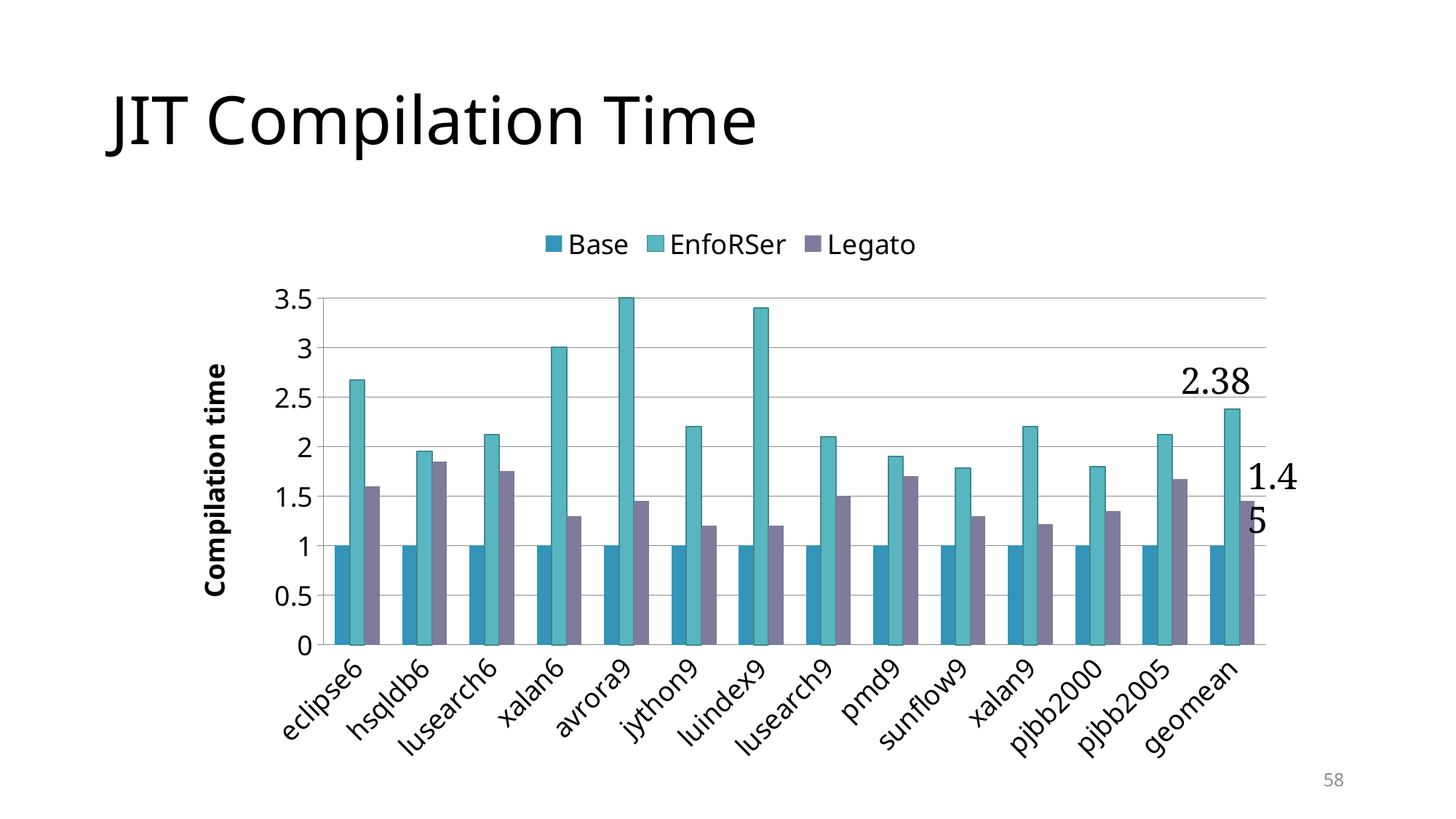
Which category has the highest Legato bar? hsqldb6 What kind of chart is shown on the slide? bar chart What is the Legato value for geomean? 1.45 What is the difference between the EnfoRSer and Legato values for geomean? 0.93 Is the Legato value for eclipse6 greater or less than 2? less How many series does the legend list? 3 How many categories are shown along the x axis? 14 What is the EnfoRSer value for geomean? 2.38 Is the EnfoRSer value for xalan6 greater or less than 2.5? greater For avrora9, which is larger: the EnfoRSer value or the Legato value? EnfoRSer What is the Base value for eclipse6? 1 What is the label on the y axis? Compilation time